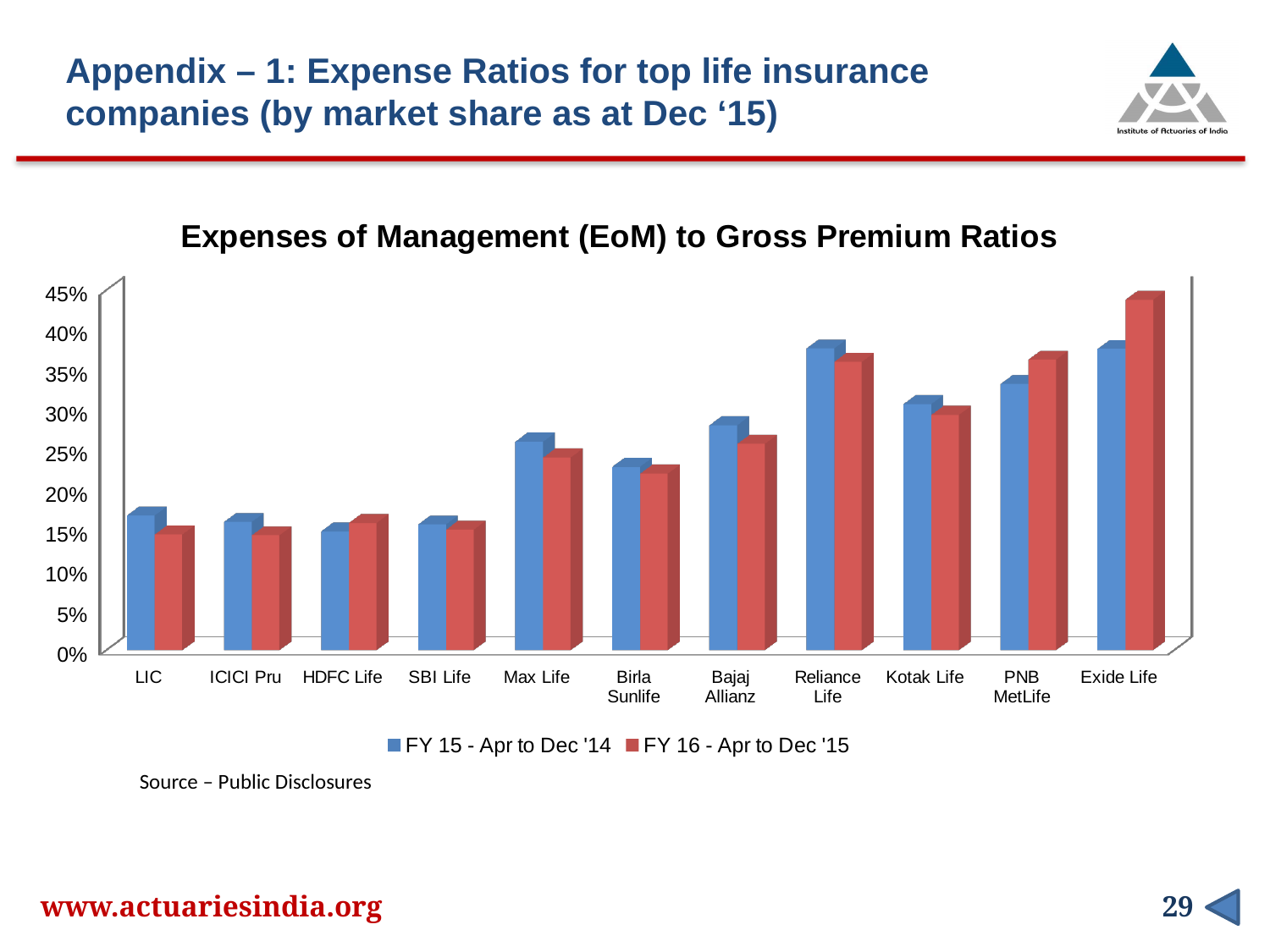
Is the FY 16 - Apr to Dec '15 value for Exide Life greater or less than 40%? greater Is the FY 16 - Apr to Dec '15 value for Kotak Life greater or less than 35%? less Is the FY 15 - Apr to Dec '14 value for Reliance Life greater or less than 35%? greater Which company has the highest FY 16 - Apr to Dec '15 expense ratio? Exide Life How many companies are shown on the x axis of the chart? 11 What kind of chart is shown on the slide? Bar chart What is the title of the chart? Expenses of Management (EoM) to Gross Premium Ratios Which has the larger FY 15 - Apr to Dec '14 value: Max Life or Birla Sunlife? Max Life How many series does the chart's legend list? 2 For PNB MetLife, which is larger: the FY 15 - Apr to Dec '14 value or the FY 16 - Apr to Dec '15 value? FY 16 - Apr to Dec '15